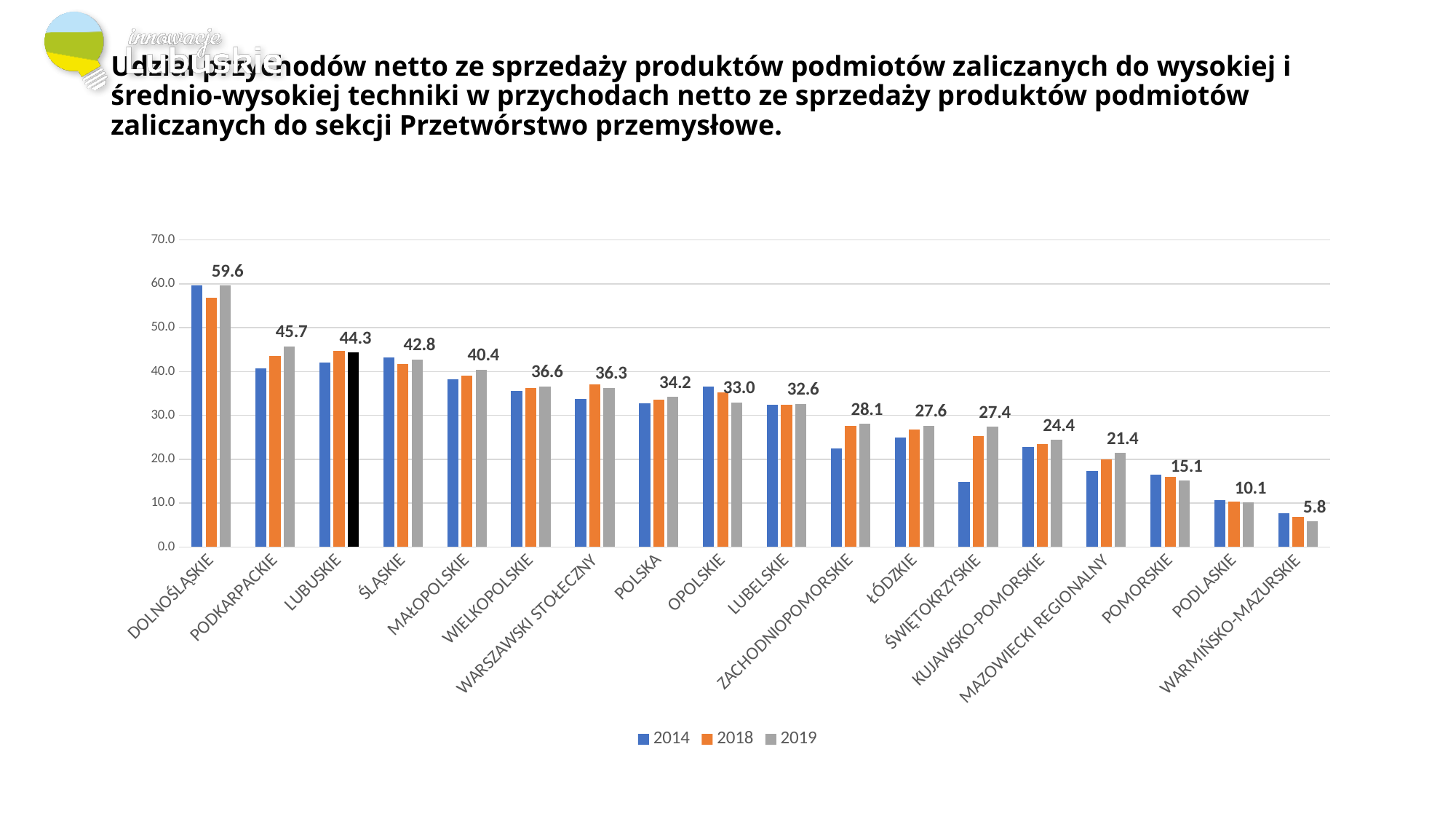
What is the 2019 value for DOLNOŚLĄSKIE? 59.6 What is the 2019 value for POLSKA? 34.2 Which has the larger 2019 value, ŚLĄSKIE or MAŁOPOLSKIE? ŚLĄSKIE How many series does the legend list? 3 Which category has the lowest 2019 value? WARMIŃSKO-MAZURSKIE How many categories are shown on the x axis? 18 Is the 2014 value for DOLNOŚLĄSKIE greater or less than 50.0? greater What kind of chart is shown on the slide? bar chart What is the difference between the 2019 values for DOLNOŚLĄSKIE and LUBUSKIE? 15.3 Which category has the highest 2019 value? DOLNOŚLĄSKIE What is the 2019 value for LUBUSKIE? 44.3 Is the 2014 value for ŚWIĘTOKRZYSKIE greater or less than 20.0? less